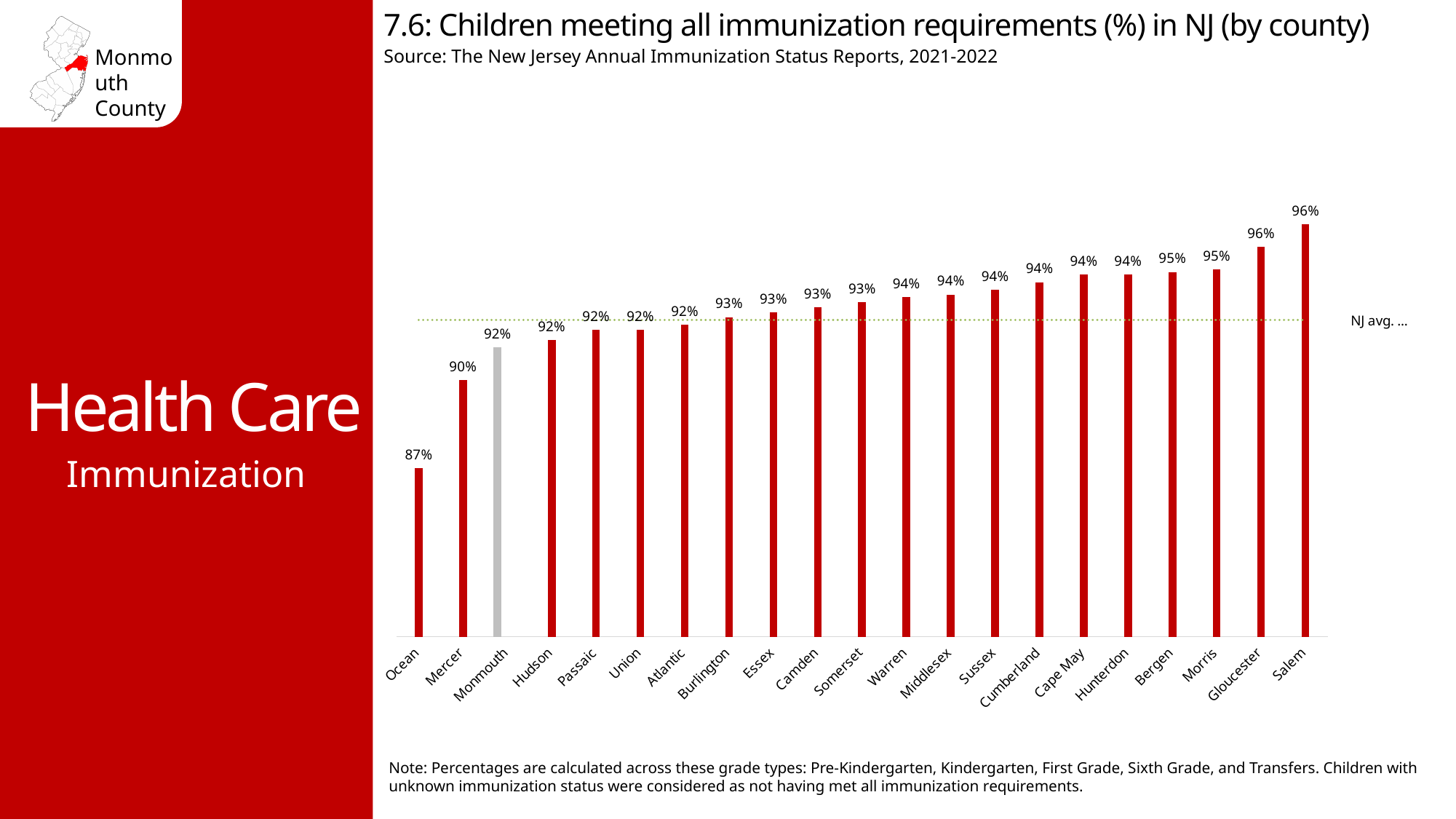
What is the value for Mercer County? 90% How many counties are shown in the chart? 21 Do the values rise or fall moving from left to right along the x axis? Rise What is the difference in percentage points between Monmouth and Ocean? 5 percentage points What percentage is shown for Bergen County? 95% What is the difference in percentage points between Salem and Ocean? 9 percentage points What type of chart is used on this slide? Bar chart Which county has the lowest percentage of children meeting all immunization requirements? Ocean Which has a higher value, Mercer or Hudson? Hudson Which county's bar is shown in grey instead of red? Monmouth What percentage of children in Monmouth County met all immunization requirements? 92% What is the value shown for Ocean County? 87%